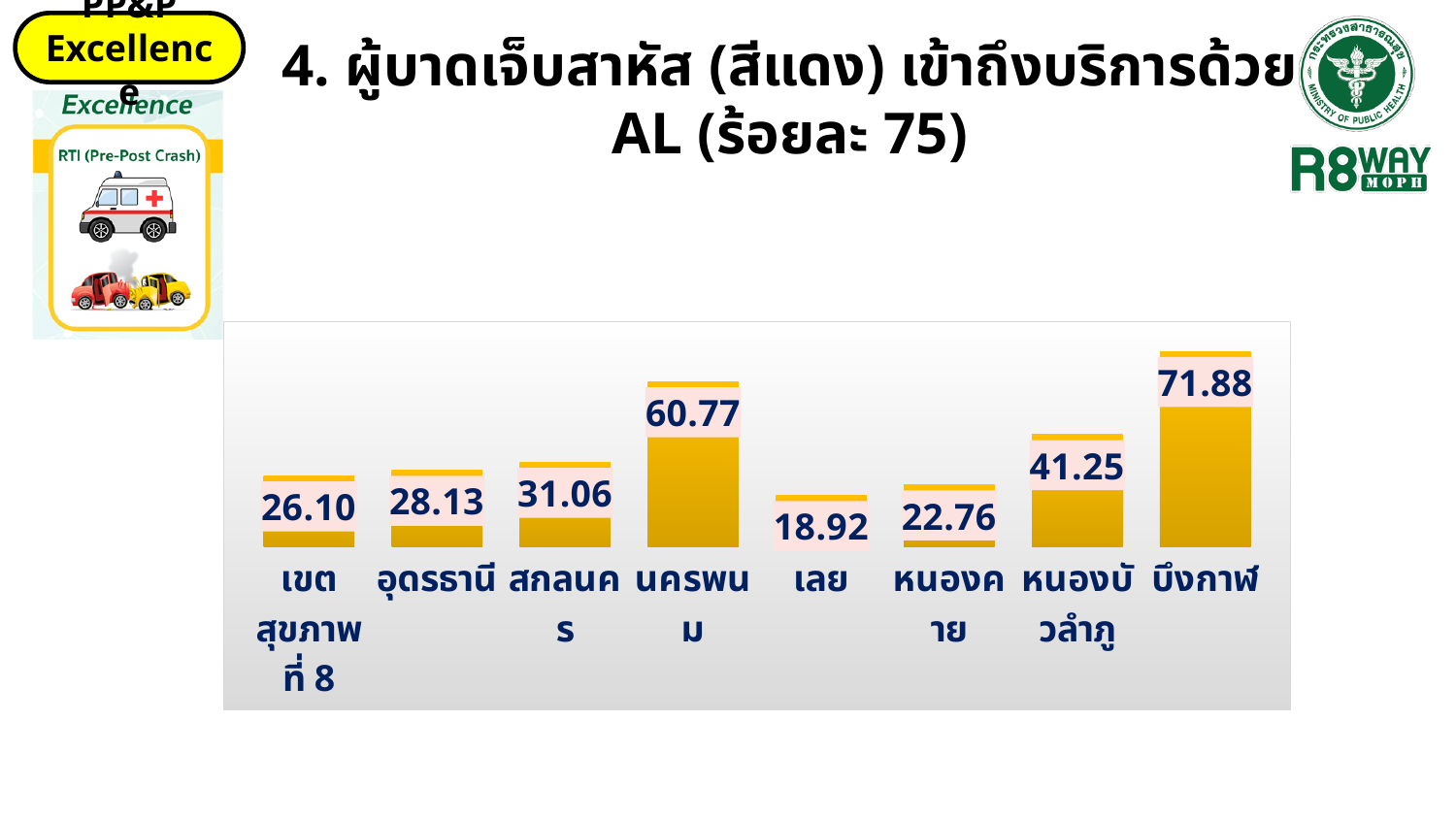
How many categories are shown in the chart? 8 Which category has the highest value? บึงกาฬ What is the difference between the values for สกลนคร and อุดรธานี? 2.93 What colour are the bars in the chart? Yellow/gold Which is larger, the value for หนองคาย or the value for เลย? หนองคาย What is the difference between the values for บึงกาฬ and นครพนม? 11.11 What is the value for นครพนม? 60.77 Which category has the lowest value? เลย What kind of chart is shown on the slide? Bar chart What is the value for หนองบัวลำภู? 41.25 What is the value for บึงกาฬ? 71.88 What is the value for เขตสุขภาพที่ 8? 26.10